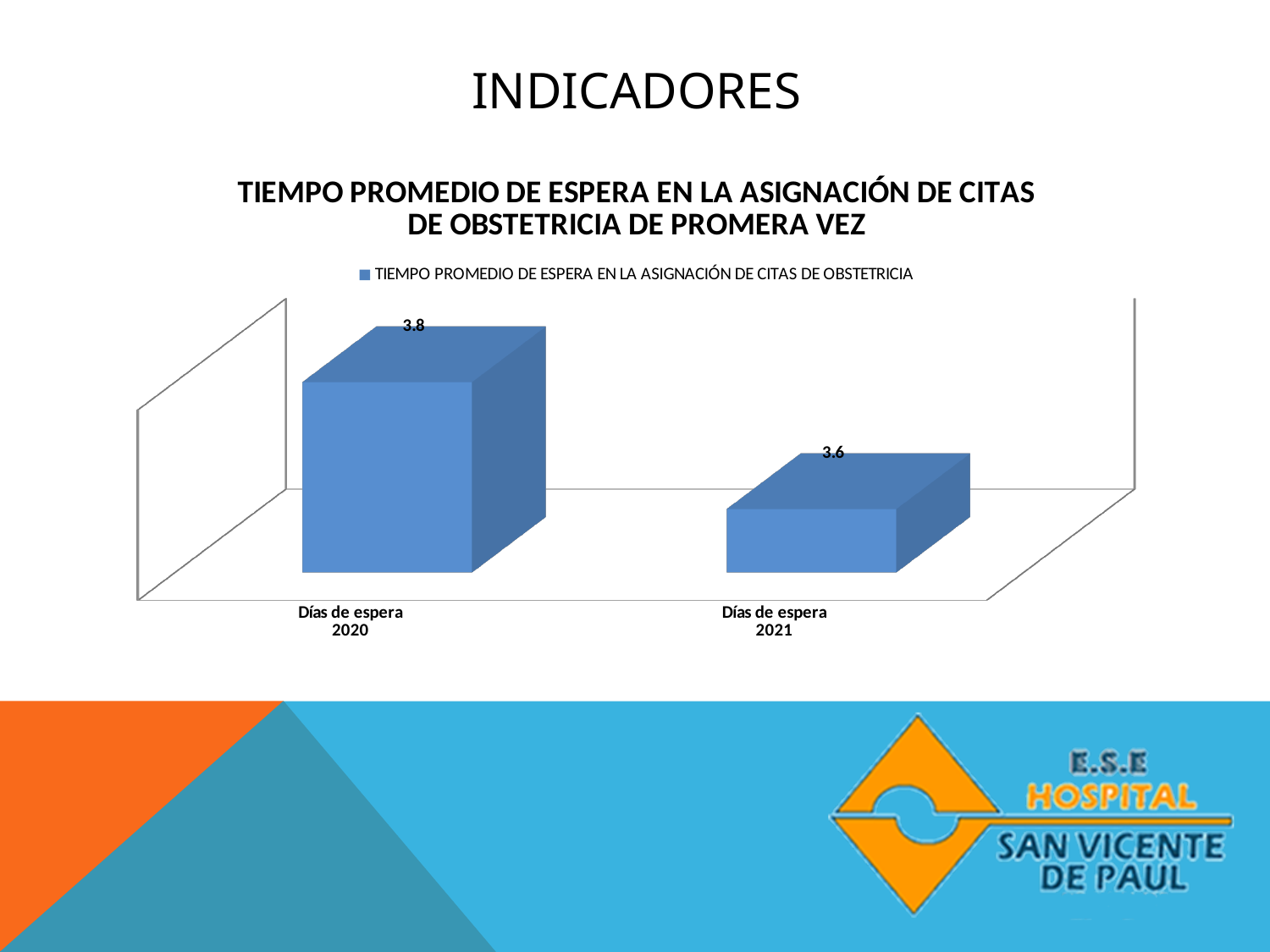
What is the title of the chart? TIEMPO PROMEDIO DE ESPERA EN LA ASIGNACIÓN DE CITAS DE OBSTETRICIA DE PROMERA VEZ What is the difference between the values for Días de espera 2020 and Días de espera 2021? 0.2 What kind of chart is shown on the slide? Bar chart Do the values rise or fall from 2020 to 2021? Fall How many categories are shown in the chart? 2 What is the value for Días de espera 2021? 3.6 Which category has the lowest value? Días de espera 2021 What is the value for Días de espera 2020? 3.8 Which is larger, the value for Días de espera 2020 or Días de espera 2021? Días de espera 2020 How many series does the legend list? 1 Which category has the highest value? Días de espera 2020 What colour are the bars in the chart? Blue